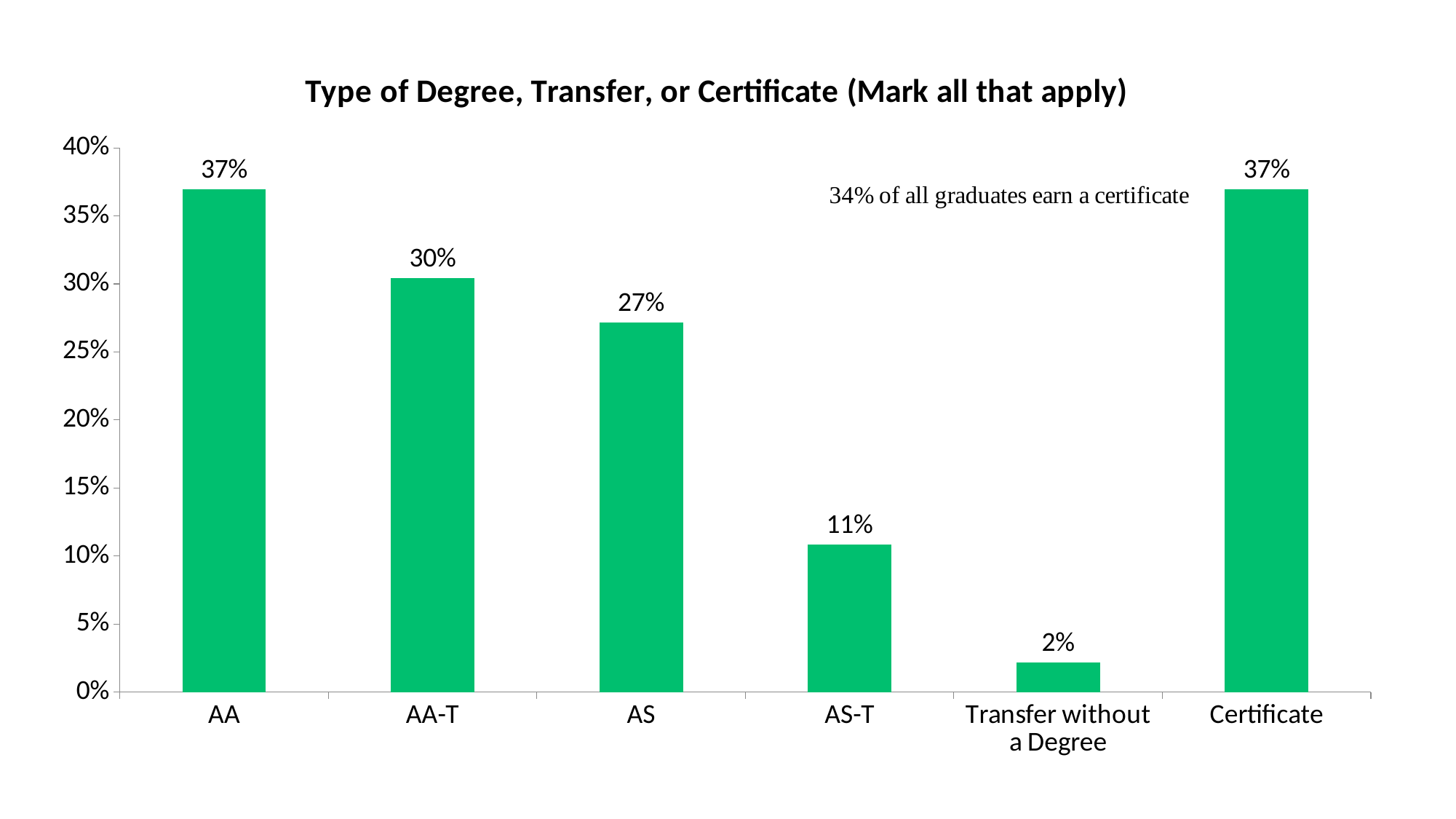
What is the value for Transfer without a Degree? 2% What is the difference between the values for AA-T and AS-T? 19% What is the title of the chart? Type of Degree, Transfer, or Certificate (Mark all that apply) How many categories are shown on the x axis? 6 What is the value for AA? 37% What is the value for Certificate? 37% What is the value for AA-T? 30% What is the value for AS? 27% Which is larger, the value for AS or the value for AS-T? AS What kind of chart is shown on the slide? Bar chart Which category has the lowest value? Transfer without a Degree What is the value for AS-T? 11%